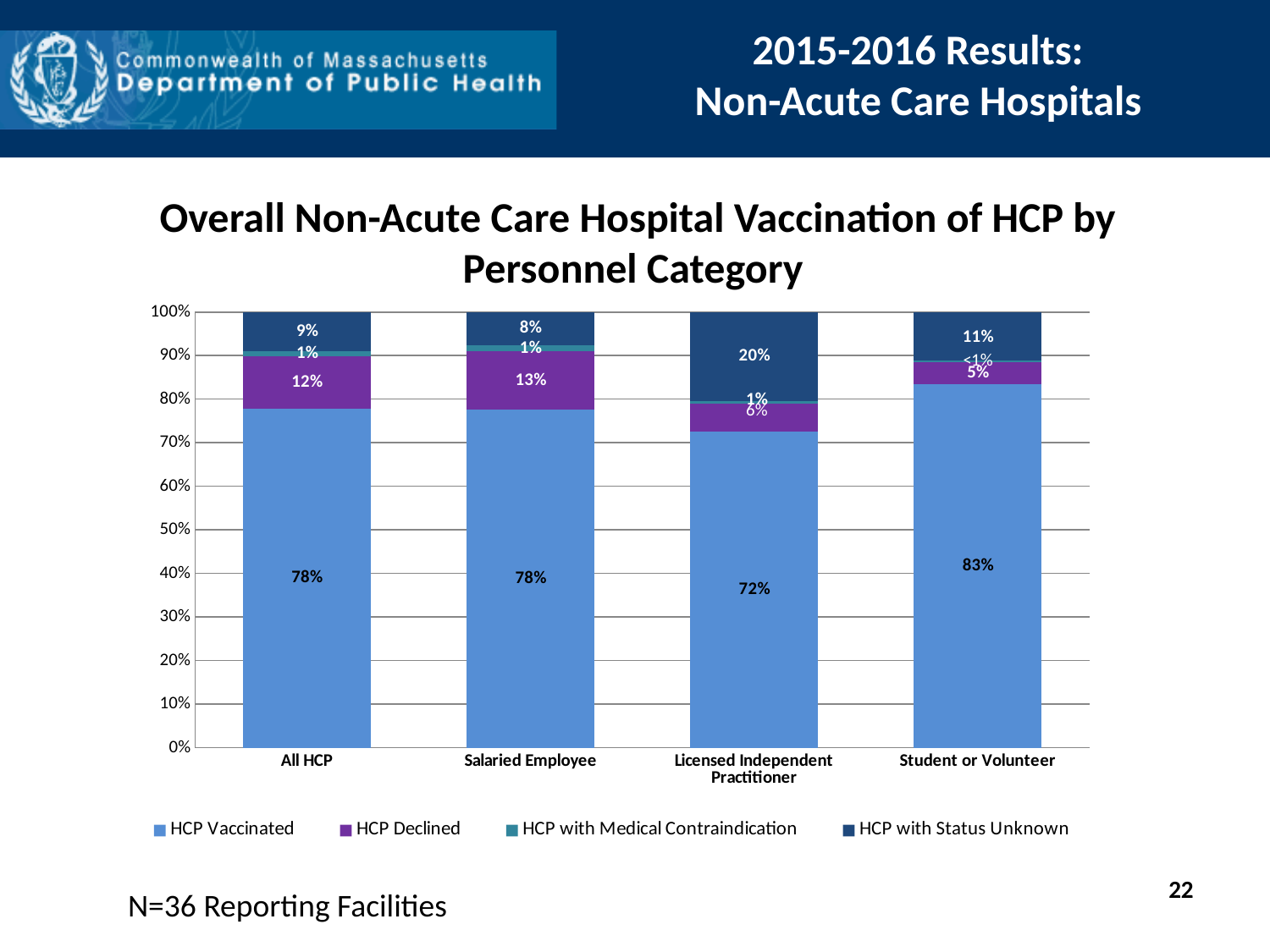
What type of chart is shown on the slide? Stacked bar chart How many series does the legend list? 4 Which personnel category has the highest HCP Vaccinated value? Student or Volunteer What is the HCP Declined value for Salaried Employee? 13% What is the title of the chart? Overall Non-Acute Care Hospital Vaccination of HCP by Personnel Category How many personnel categories are shown on the x axis? 4 Which personnel category has the lowest HCP Vaccinated value? Licensed Independent Practitioner What is the HCP with Medical Contraindication value for Student or Volunteer? <1% What is the HCP with Status Unknown value for Licensed Independent Practitioner? 20% What is the difference between the HCP with Status Unknown values for Licensed Independent Practitioner and Salaried Employee? 12% Is the HCP Declined value larger for All HCP or for Student or Volunteer? All HCP What is the HCP Vaccinated value for Licensed Independent Practitioner? 72%